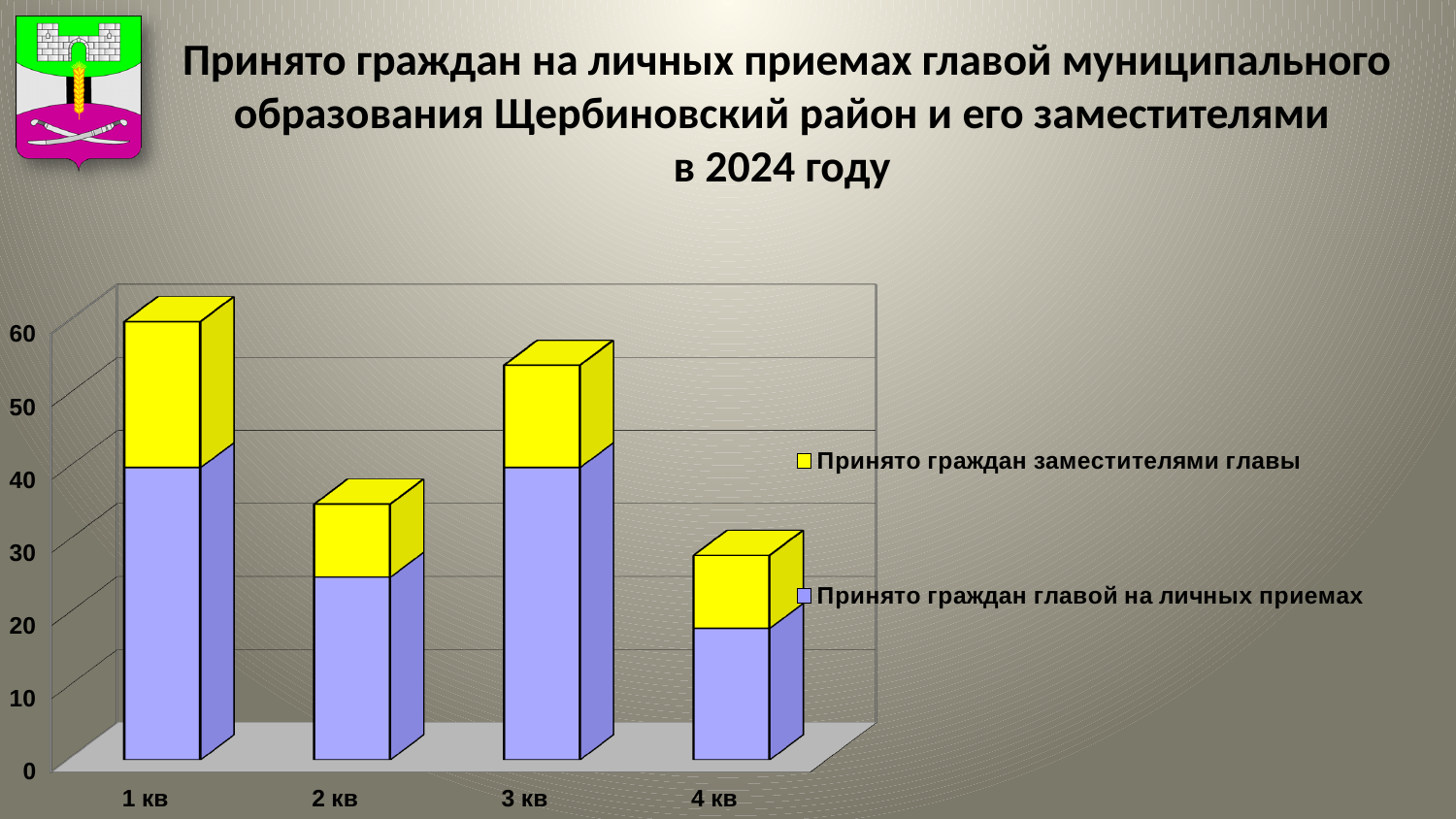
Which has the larger total bar, 2 кв or 3 кв? 3 кв Which colour represents 'Принято граждан заместителями главы' in the legend? yellow Is the total bar for 2 кв greater or less than 50? less Does the total bar rise or fall from 3 кв to 4 кв? fall Which quarter has the highest total bar? 1 кв What kind of chart is shown on the slide? stacked bar chart Is the total bar for 1 кв greater or less than 50? greater How many quarters (categories) are shown on the x axis? 4 Is the total bar for 4 кв greater or less than 40? less Which quarter has the lowest total bar? 4 кв How many series does the legend list? 2